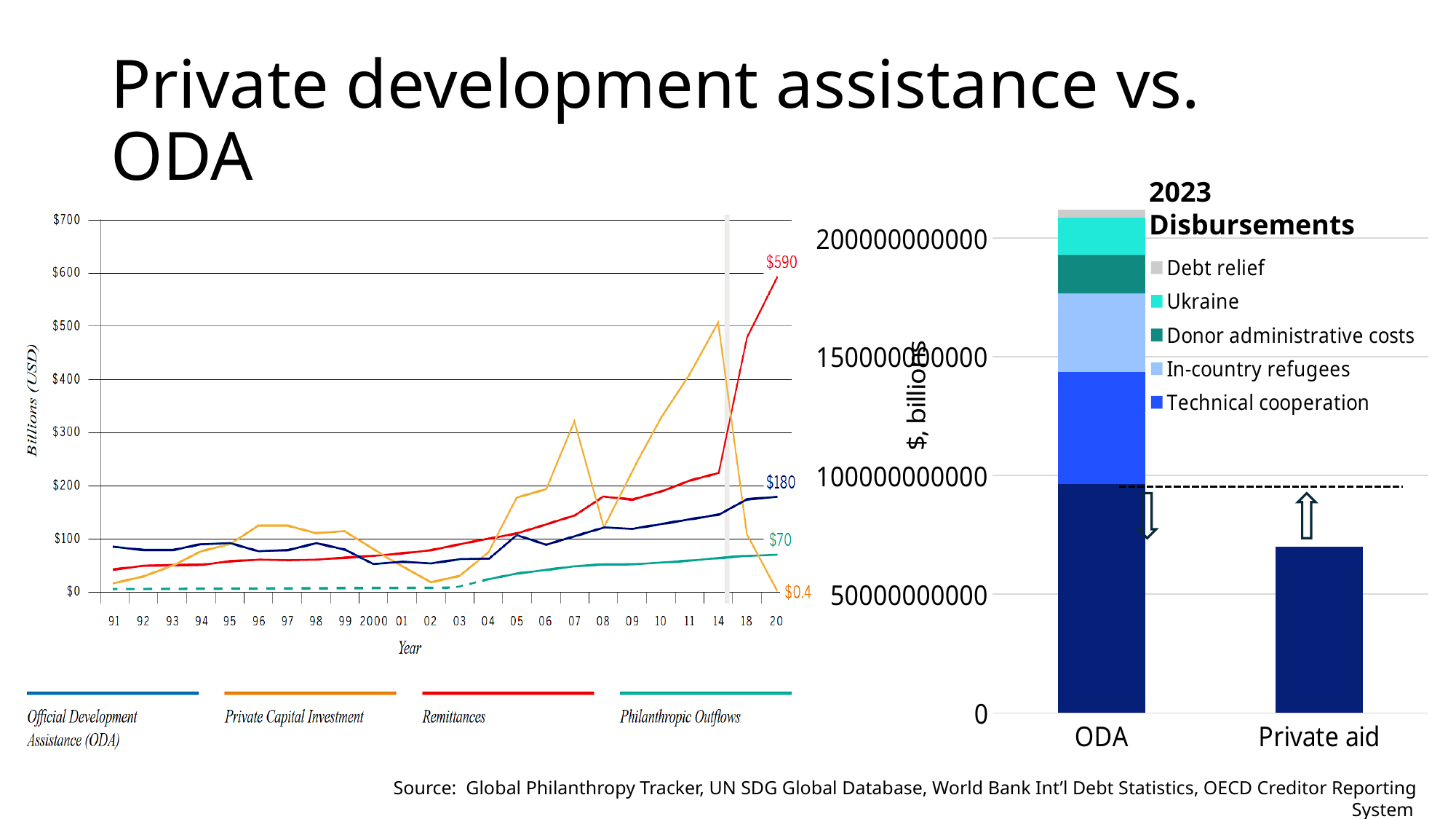
In the left-hand line chart, which series has the lowest value at year 20? Private Capital Investment In the left-hand line chart, which series has the highest value at year 20? Remittances In the left-hand line chart, what is the difference between the Remittances value and the ODA value at year 20? $410 What kind of chart is the '2023 Disbursements' chart on the right? bar chart In the left-hand line chart, what value is labelled for Private Capital Investment at year 20? $0.4 In the '2023 Disbursements' chart, is the value for Private aid greater or less than 100000000000? less In the left-hand line chart, what value is labelled for Remittances at year 20? $590 How many series does the legend of the left-hand line chart list? 4 In the left-hand line chart, what value is labelled for Official Development Assistance (ODA) at year 20? $180 What kind of chart is the left-hand chart on the slide? line chart In the '2023 Disbursements' chart, which bar is taller, ODA or Private aid? ODA In the left-hand line chart, what value is labelled for Philanthropic Outflows at year 20? $70